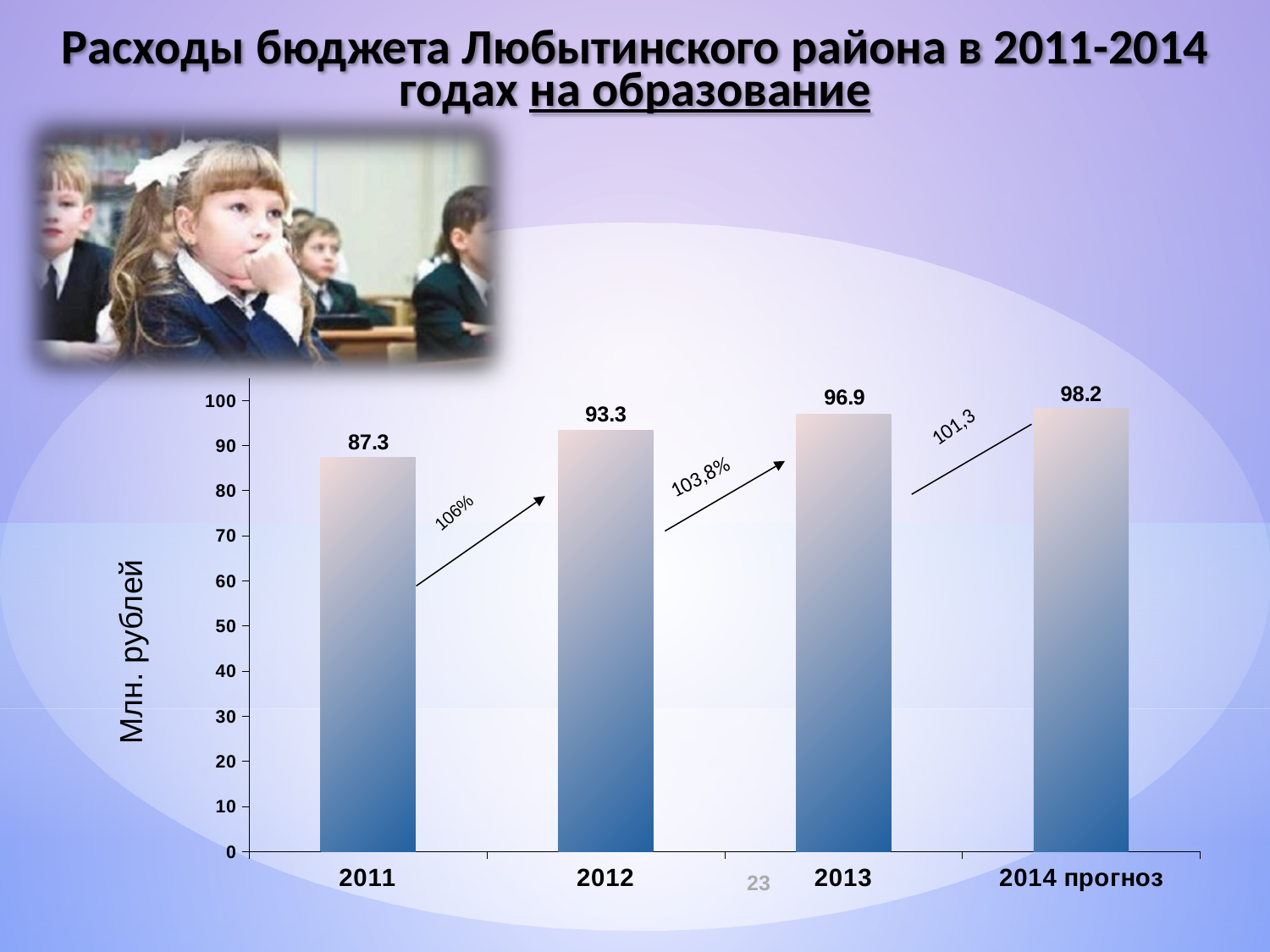
What is the value for 2014 прогноз? 98.2 Which year has the lowest value? 2011 What is the difference between the values for 2014 прогноз and 2013? 1.3 Which year has the highest value? 2014 прогноз How many bars are shown in the chart? 4 What is the value for 2011? 87.3 Do the values rise or fall from 2011 to 2014 прогноз? rise What is the value for 2012? 93.3 What is the difference between the values for 2012 and 2011? 6.0 Which is larger, the value for 2013 or the value for 2012? 2013 What kind of chart is shown on the slide? bar chart What is the value for 2013? 96.9